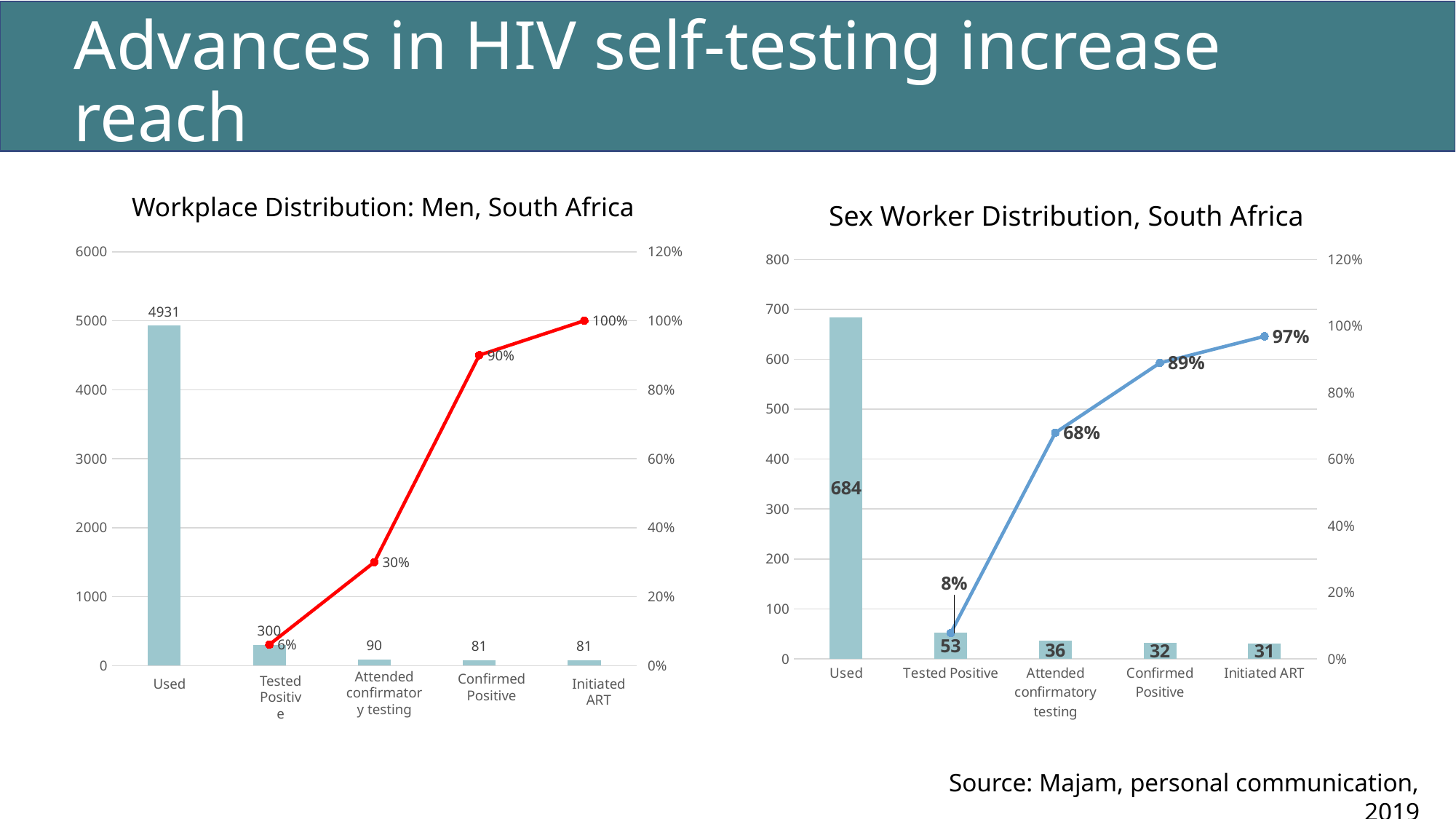
In the 'Sex Worker Distribution, South Africa' chart, what percentage is shown on the line for Attended confirmatory testing? 68% In the 'Workplace Distribution: Men, South Africa' chart, what is the value for Used? 4931 In the 'Sex Worker Distribution, South Africa' chart, what is the value for Used? 684 In the 'Workplace Distribution: Men, South Africa' chart, which category has the highest bar? Used In the 'Workplace Distribution: Men, South Africa' chart, what is the value for Tested Positive? 300 In the 'Workplace Distribution: Men, South Africa' chart, how many categories are shown on the x axis? 5 In the 'Sex Worker Distribution, South Africa' chart, what colour is the line? blue In the 'Sex Worker Distribution, South Africa' chart, what is the value for Confirmed Positive? 32 In the 'Workplace Distribution: Men, South Africa' chart, what is the difference between the values for Tested Positive and Attended confirmatory testing? 210 In the 'Sex Worker Distribution, South Africa' chart, what is the difference between the values for Tested Positive and Initiated ART? 22 In the 'Workplace Distribution: Men, South Africa' chart, what percentage is shown on the line for Attended confirmatory testing? 30% In the 'Sex Worker Distribution, South Africa' chart, does the line rise or fall from Tested Positive to Initiated ART? rise